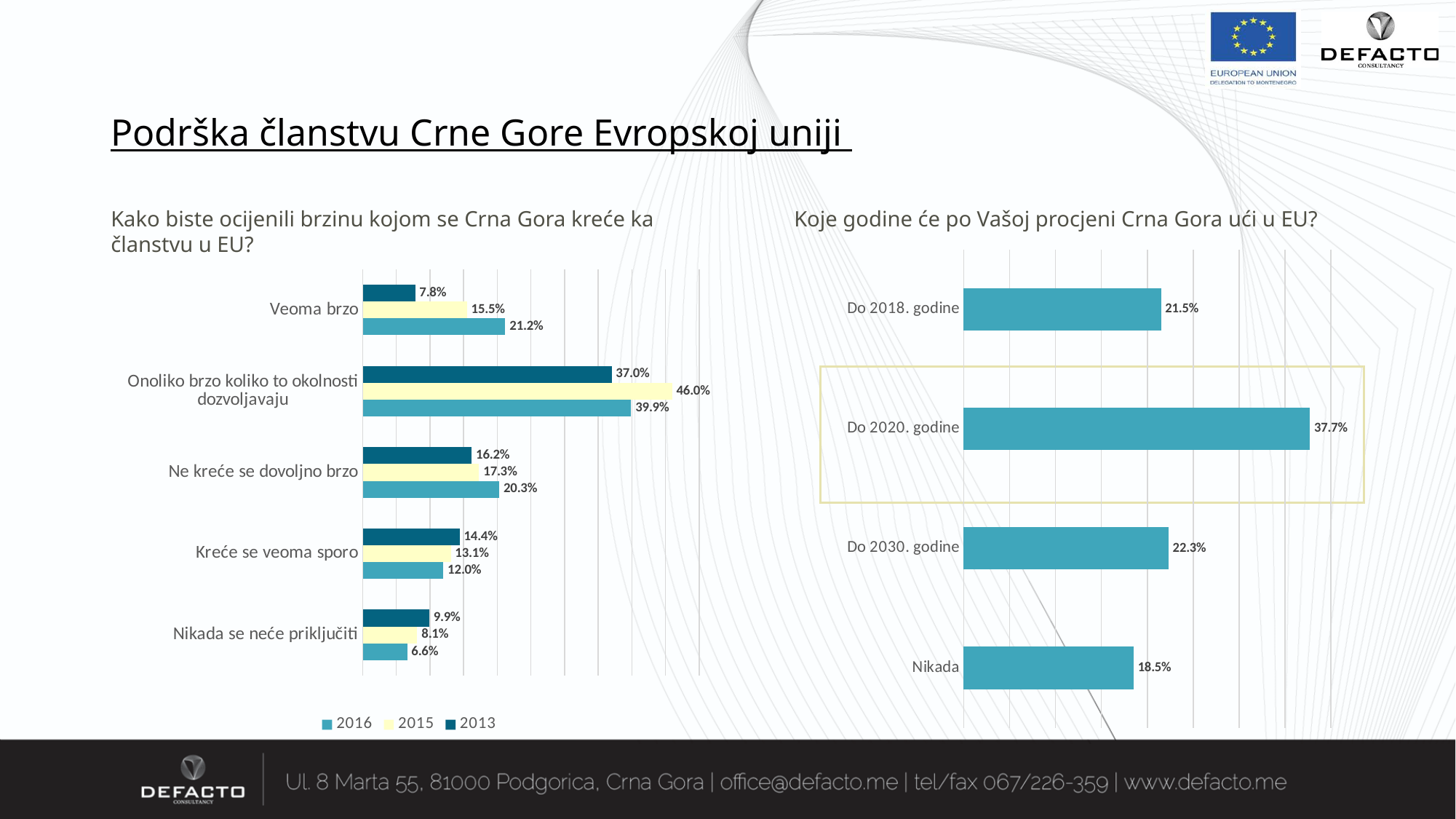
In the left chart (Kako biste ocijenili brzinu...), what is the 2013 value for 'Nikada se neće priključiti'? 9.9% In the left chart (Kako biste ocijenili brzinu...), what is the 2015 value for 'Onoliko brzo koliko to okolnosti dozvoljavaju'? 46.0% In the right chart (Koje godine će po Vašoj procjeni Crna Gora ući u EU?), how many categories are shown? 4 In the right chart (Koje godine će po Vašoj procjeni Crna Gora ući u EU?), what is the difference between 'Do 2030. godine' and 'Do 2018. godine'? 0.8% In the left chart (Kako biste ocijenili brzinu...), which category has the highest 2016 value? Onoliko brzo koliko to okolnosti dozvoljavaju What kind of chart is the right chart (Koje godine će po Vašoj procjeni Crna Gora ući u EU?)? Bar chart In the left chart (Kako biste ocijenili brzinu...), which is larger for 'Kreće se veoma sporo': the 2013 value or the 2016 value? 2013 In the right chart (Koje godine će po Vašoj procjeni Crna Gora ući u EU?), which category has the lowest value? Nikada In the right chart (Koje godine će po Vašoj procjeni Crna Gora ući u EU?), what is the value for 'Do 2020. godine'? 37.7% In the left chart (Kako biste ocijenili brzinu...), how many series does the legend list? 3 In the left chart (Kako biste ocijenili brzinu...), what is the difference between the 2016 and 2013 values for 'Veoma brzo'? 13.4% In the left chart (Kako biste ocijenili brzinu...), what is the 2016 value for 'Veoma brzo'? 21.2%